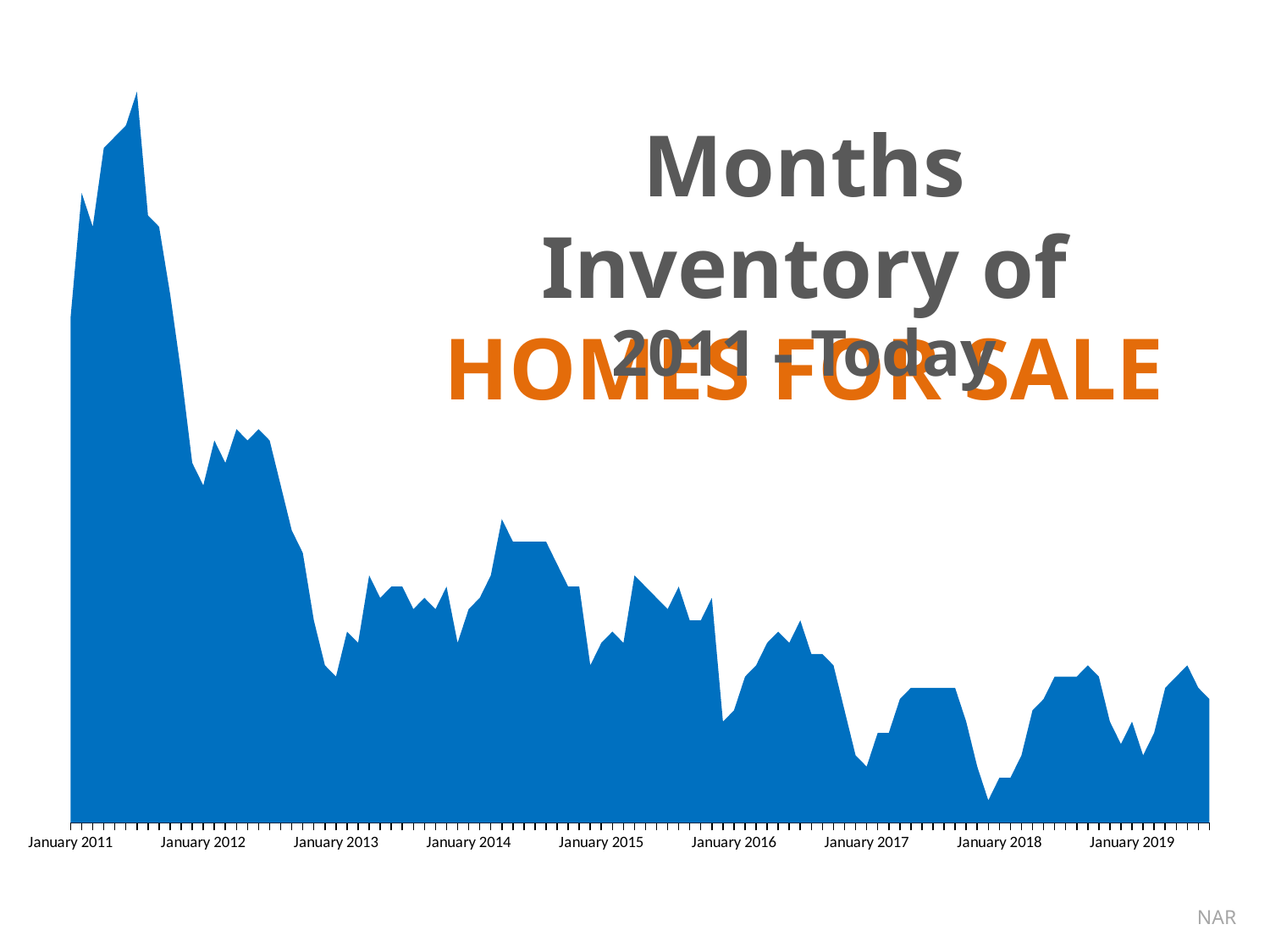
What is the first label on the x axis? January 2011 What kind of chart is shown on the slide? Area chart How many year labels are shown along the x axis? 9 What colour is the shaded area of the chart? Blue In which year does the chart reach its lowest point? 2017 Which is higher, the value at January 2011 or the value at January 2019? January 2011 Overall, do the values rise or fall from January 2011 to January 2019? Fall What is the last label on the x axis? January 2019 What source is cited at the bottom right of the slide? NAR Which is higher, the value at January 2012 or the value at January 2017? January 2012 Which is higher, the value at January 2014 or the value at January 2018? January 2014 In which year does the chart reach its highest point? 2011